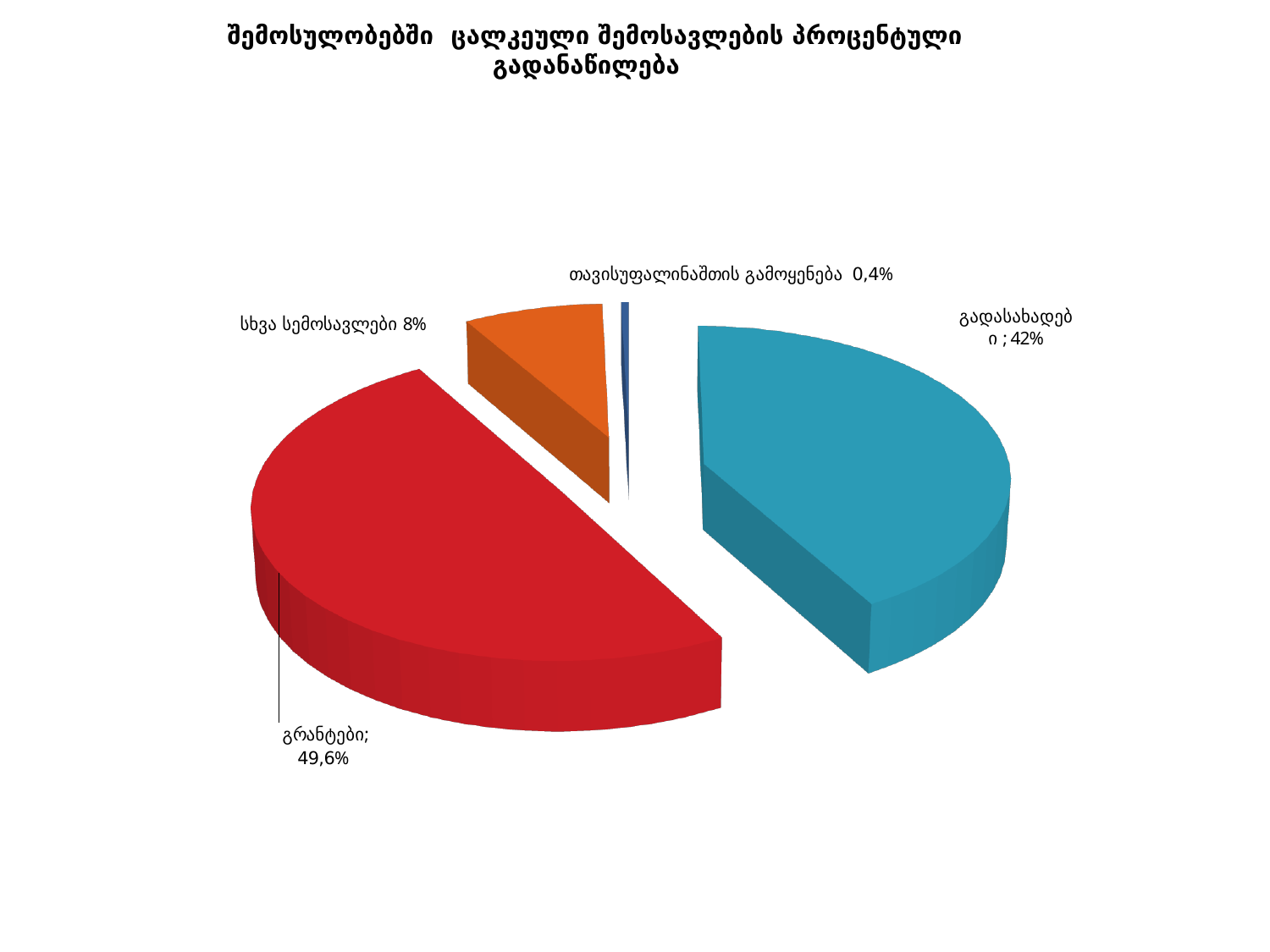
Which category has the smallest share of the pie? თავისუფალი ნაშთის გამოყენება What percentage is shown for თავისუფალი ნაშთის გამოყენება? 0,4% What percentage is shown for სხვა შემოსავლები? 8% What is the title of the chart? შემოსულობებში ცალკეული შემოსავლების პროცენტული გადანაწილება Which is larger, the share for გადასახადები or the share for სხვა შემოსავლები? გადასახადები What kind of chart is shown on the slide? pie chart What is the difference in percentage points between გრანტები and გადასახადები? 7,6 What colour is the slice for გრანტები? red Which category has the largest share of the pie? გრანტები What percentage is shown for გრანტები? 49,6% How many slices does the pie chart have? 4 What percentage is shown for გადასახადები? 42%